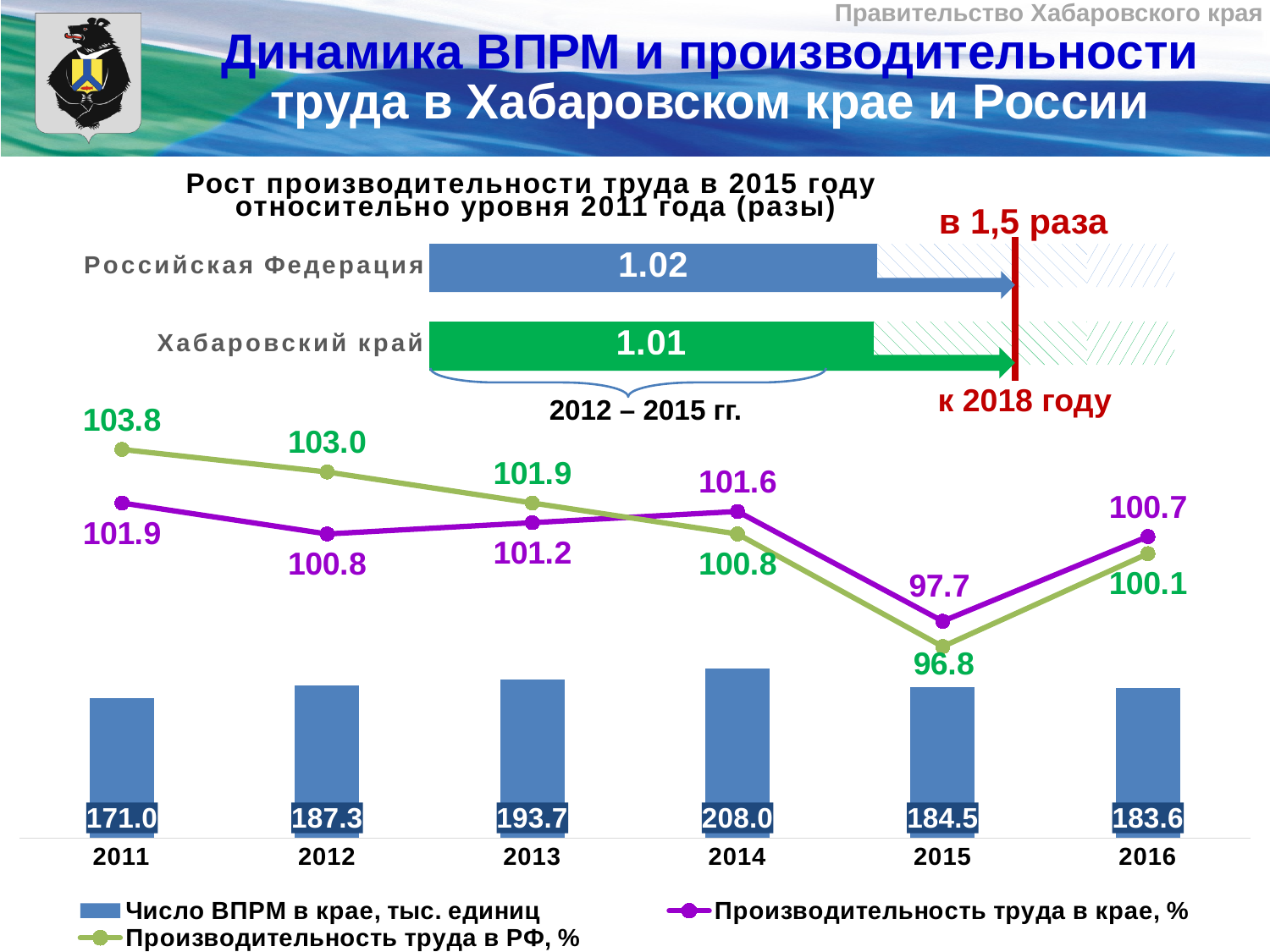
In the bottom chart, how many series does the legend list? 3 In the top chart, which category has the higher value, Российская Федерация or Хабаровский край? Российская Федерация In the bottom chart, what is the difference between Число ВПРМ в крае in 2014 and in 2015? 23.5 In the bottom chart, what is the value of Число ВПРМ в крае, тыс. единиц for 2014? 208.0 In the bottom chart, what is the value of Производительность труда в РФ, % for 2015? 96.8 In the top chart (Рост производительности труда в 2015 году относительно уровня 2011 года), what is the value for Хабаровский край? 1.01 In the bottom chart, what is the value of Производительность труда в крае, % for 2016? 100.7 In the bottom chart, in which year is Число ВПРМ в крае, тыс. единиц the highest? 2014 In the bottom chart, does Производительность труда в РФ, % rise or fall from 2011 to 2015? fall In the top chart (Рост производительности труда в 2015 году относительно уровня 2011 года), what is the value for Российская Федерация? 1.02 In the bottom chart, in which year is Число ВПРМ в крае, тыс. единиц the lowest? 2011 In the bottom chart, how many years are shown on the x axis? 6